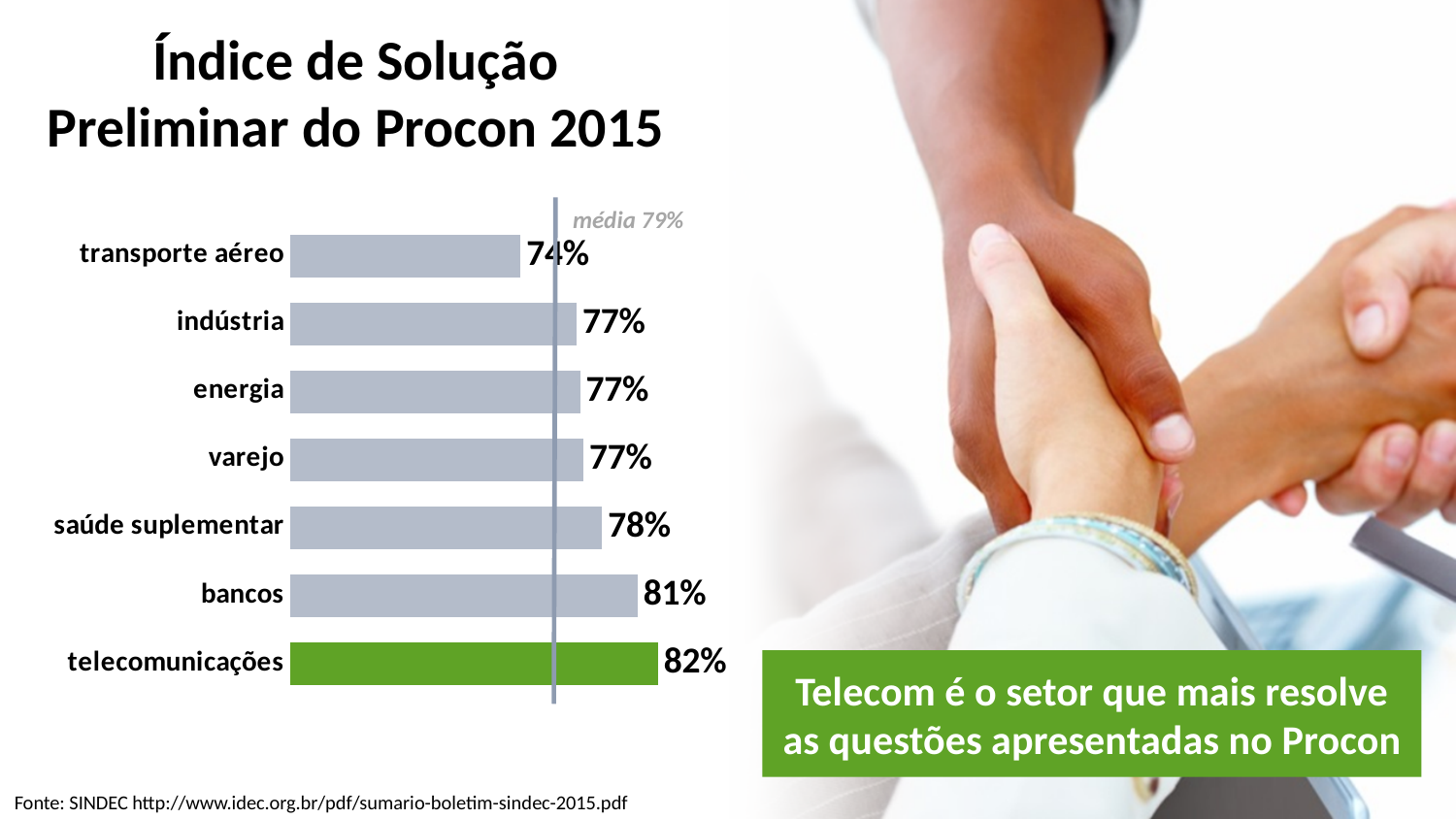
What is the difference between the values for bancos and saúde suplementar? 3% How many categories are shown in the chart? 7 What kind of chart is shown on the slide? bar chart Which is larger, the value for bancos or the value for varejo? bancos What is the difference between the values for telecomunicações and transporte aéreo? 8% What is the value for telecomunicações? 82% What is the value for bancos? 81% What average value is marked by the vertical line on the chart? 79% Which category has the lowest value? transporte aéreo What is the value for saúde suplementar? 78% Which category has the highest value? telecomunicações What is the value for transporte aéreo? 74%